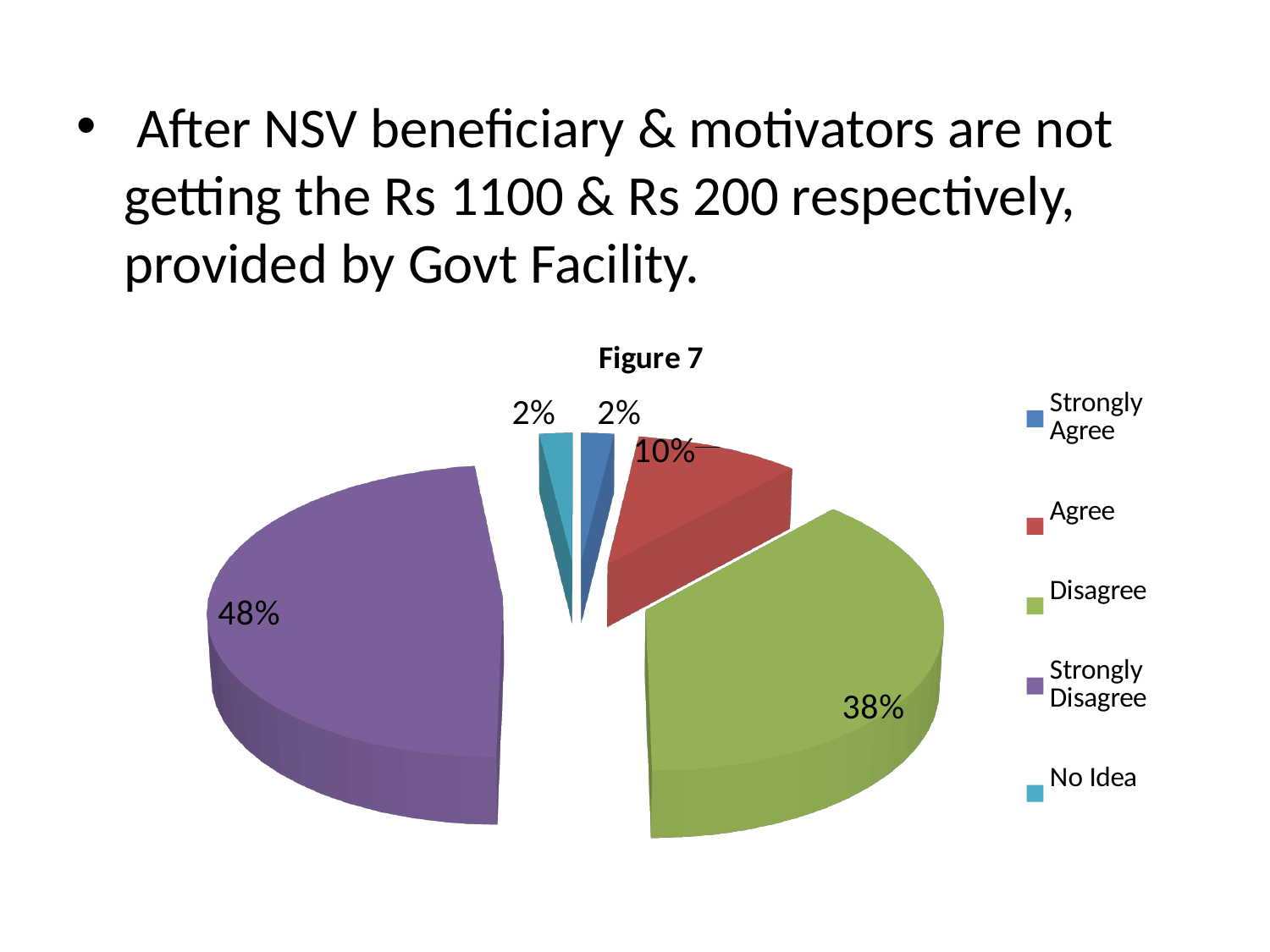
What percentage of respondents chose Strongly Disagree? 48% Which is larger, the share for Agree or the share for Disagree? Disagree What percentage of respondents chose Disagree? 38% What percentage of respondents chose Agree? 10% What type of chart is shown in Figure 7? Pie chart What is the title of the chart? Figure 7 What percentage of respondents chose No Idea? 2% Which response category has the largest share of the pie? Strongly Disagree Which colour represents the Agree category in the legend? Red What is the combined share of Disagree and Strongly Disagree? 86% How many categories does the legend list? 5 What is the difference in percentage points between Strongly Disagree and Disagree? 10